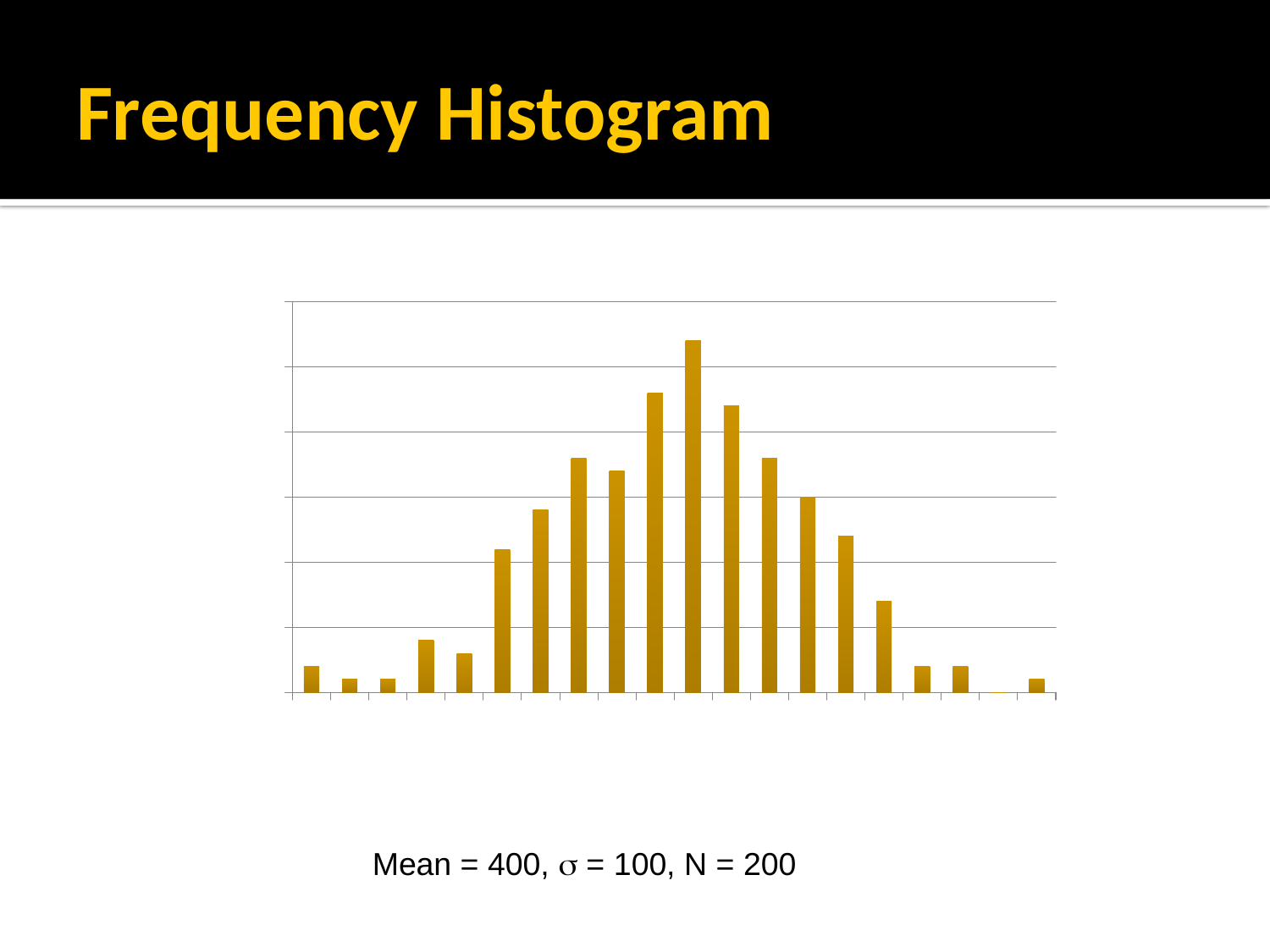
Is the tallest bar located in the left part, the middle part, or the right part of the chart? middle Does the chart display a legend? No What kind of chart is shown on the slide? bar chart What colour are the bars in the chart? gold Moving from left to right along the x axis, do the bar heights rise steadily, fall steadily, or rise and then fall? rise and then fall